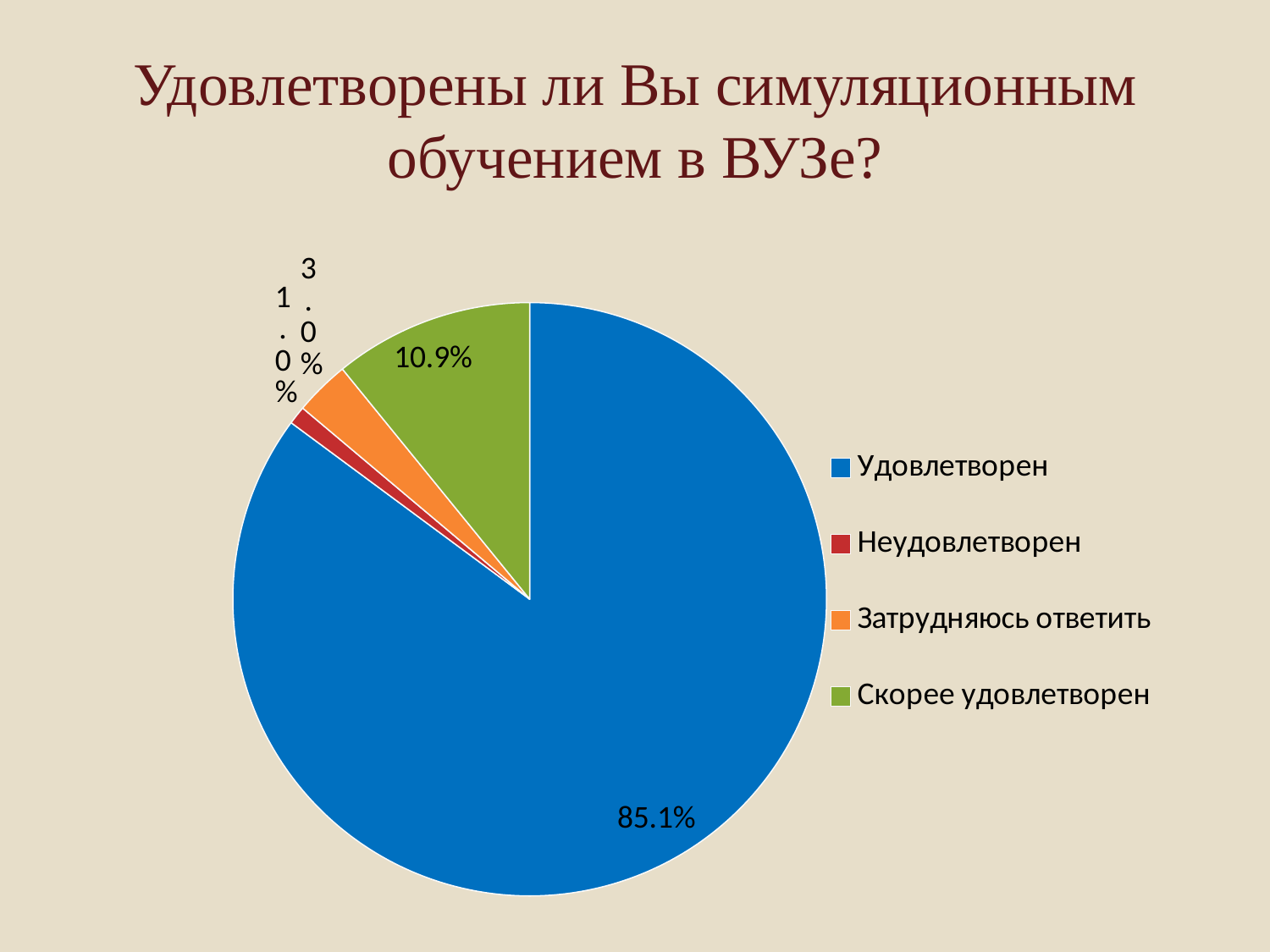
How many categories does the pie chart have? 4 Which is larger, Скорее удовлетворен or Затрудняюсь ответить? Скорее удовлетворен What kind of chart is shown on the slide? pie chart What is the value for Затрудняюсь ответить? 3.0% What is the value for Неудовлетворен? 1.0% Which category has the smallest share of the pie? Неудовлетворен Which colour represents Затрудняюсь ответить in the legend? orange What is the difference between the values for Удовлетворен and Скорее удовлетворен? 74.2% What is the value for Скорее удовлетворен? 10.9% What is the title of the chart? Удовлетворены ли Вы симуляционным обучением в ВУЗе? Which category has the largest share of the pie? Удовлетворен What is the value for Удовлетворен? 85.1%